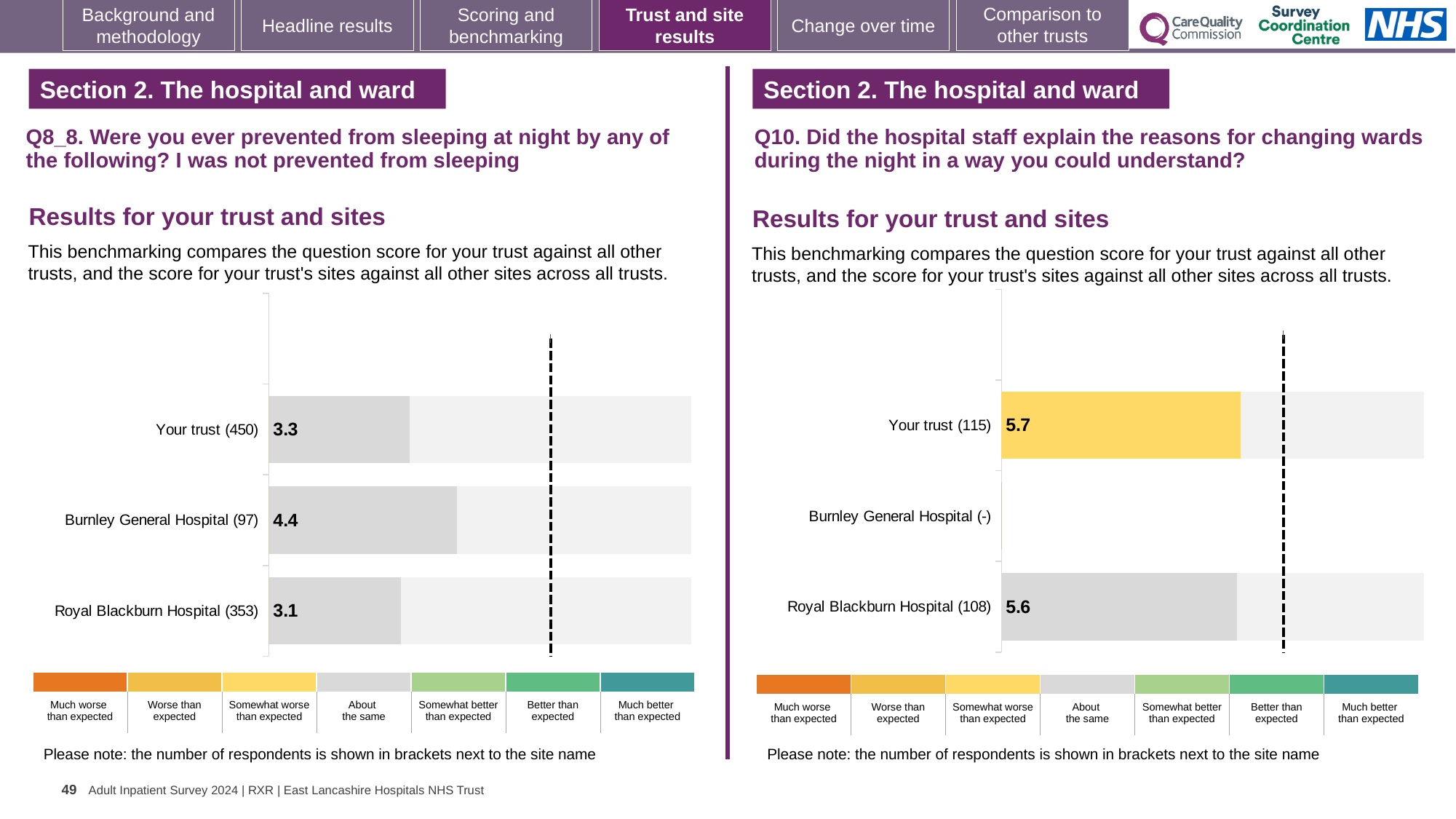
In the Q10 chart on the right, what is the score for Your trust (115)? 5.7 In the Q10 chart on the right, what is the difference between the scores for Your trust and Royal Blackburn Hospital? 0.1 In the Q10 chart on the right, which is larger, the score for Your trust or for Royal Blackburn Hospital? Your trust In the Q8_8 chart on the left, what is the score for Royal Blackburn Hospital (353)? 3.1 In the Q8_8 chart on the left, which site or trust has the highest score? Burnley General Hospital (97) In the Q8_8 chart on the left, which site or trust has the lowest score? Royal Blackburn Hospital (353) In the Q10 chart on the right, what is the score for Royal Blackburn Hospital (108)? 5.6 In the Q8_8 chart on the left, what is the score for Burnley General Hospital (97)? 4.4 In the Q8_8 chart on the left, what is the difference between the scores for Burnley General Hospital and Royal Blackburn Hospital? 1.3 In the Q8_8 chart on the left, what is the score for Your trust (450)? 3.3 How many rows (trust and sites) are shown in the Q8_8 chart on the left? 3 What kind of chart is used in the Q10 chart on the right? Bar chart